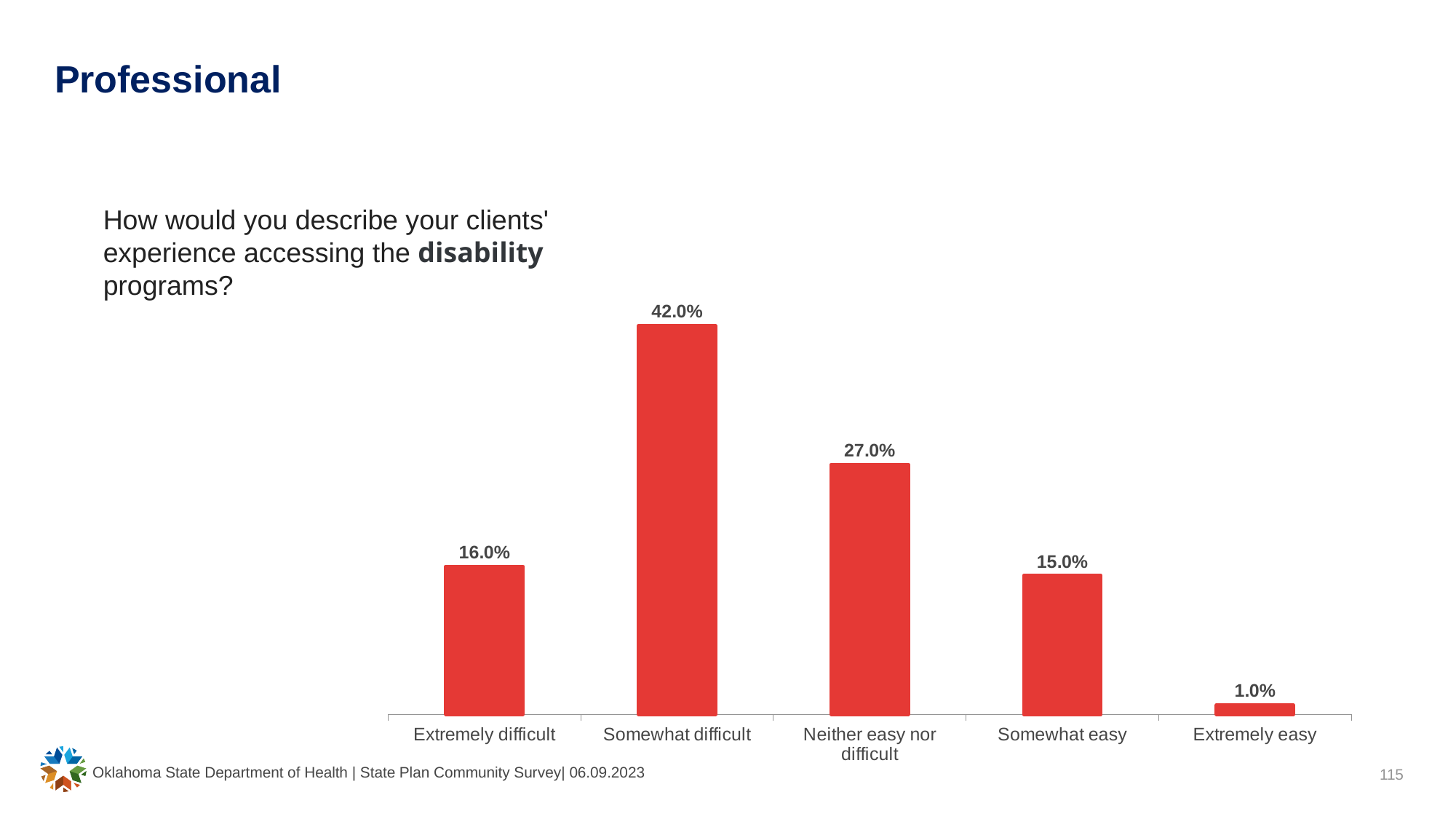
What is the difference between the values for "Somewhat difficult" and "Neither easy nor difficult"? 15.0% Which category has the lowest value? Extremely easy What is the difference between the values for "Extremely difficult" and "Somewhat easy"? 1.0% Which is larger, the value for "Extremely difficult" or the value for "Neither easy nor difficult"? Neither easy nor difficult Which category has the highest value? Somewhat difficult What is the value shown for "Extremely easy"? 1.0% What is the value shown for "Neither easy nor difficult"? 27.0% What percentage of respondents said their clients' experience accessing disability programs was "Somewhat difficult"? 42.0% How many categories are shown on the x axis of the chart? 5 What colour are the bars in the chart? Red What kind of chart is shown on the slide? Bar chart What is the value shown for "Somewhat easy"? 15.0%